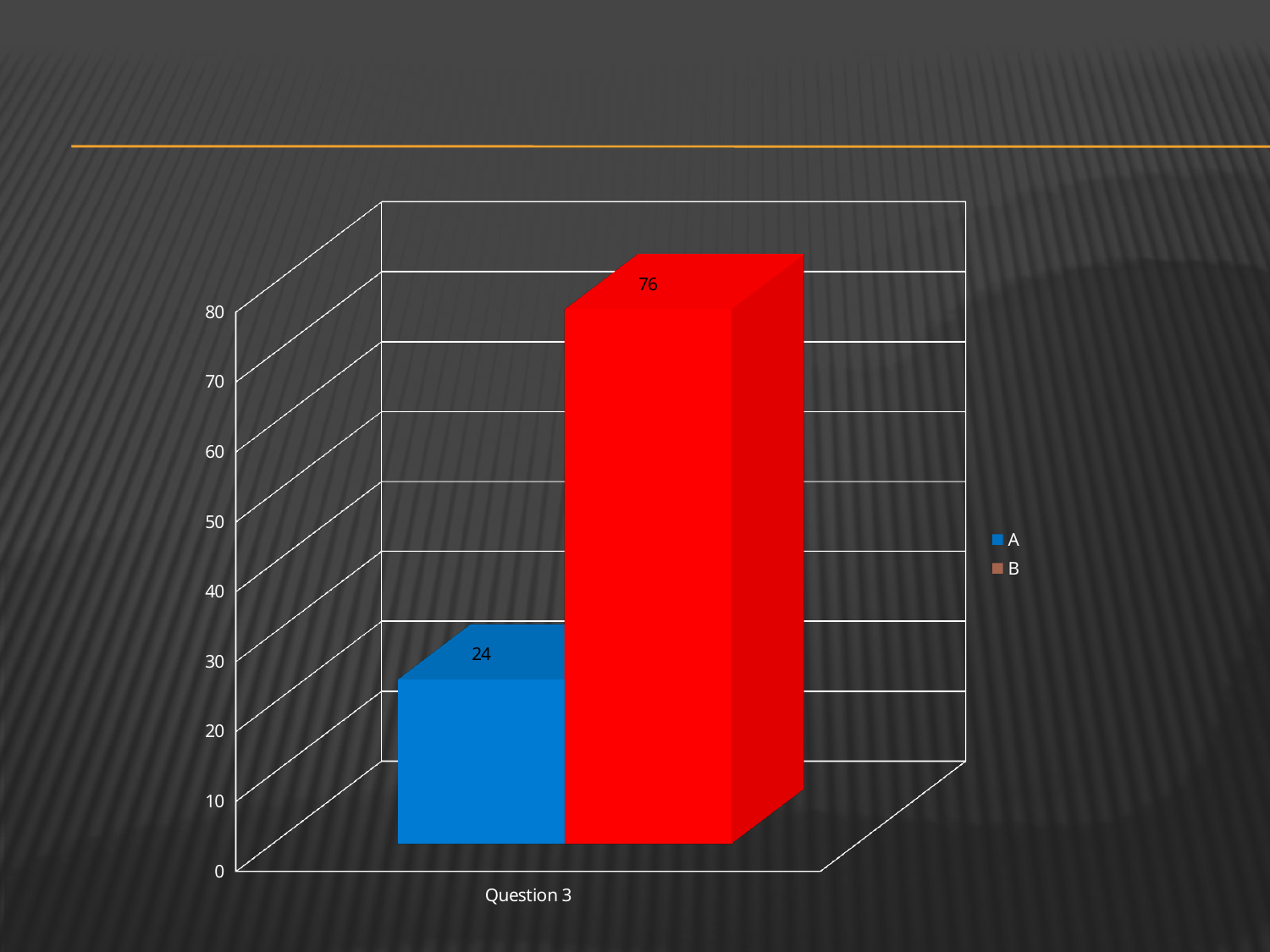
Which series has the lower value for Question 3? A How many categories are shown on the x axis? 1 Which series has the higher value for Question 3? B What is the difference between the values for B and A for Question 3? 52 Is the value for A greater or less than 30? less What kind of chart is shown on the slide? bar chart How many series does the legend list? 2 What is the value for series A for Question 3? 24 Is the value for A greater or less than the value for B? less What is the label of the category on the x axis? Question 3 What is the value for series B for Question 3? 76 Is the value for B greater or less than 70? greater